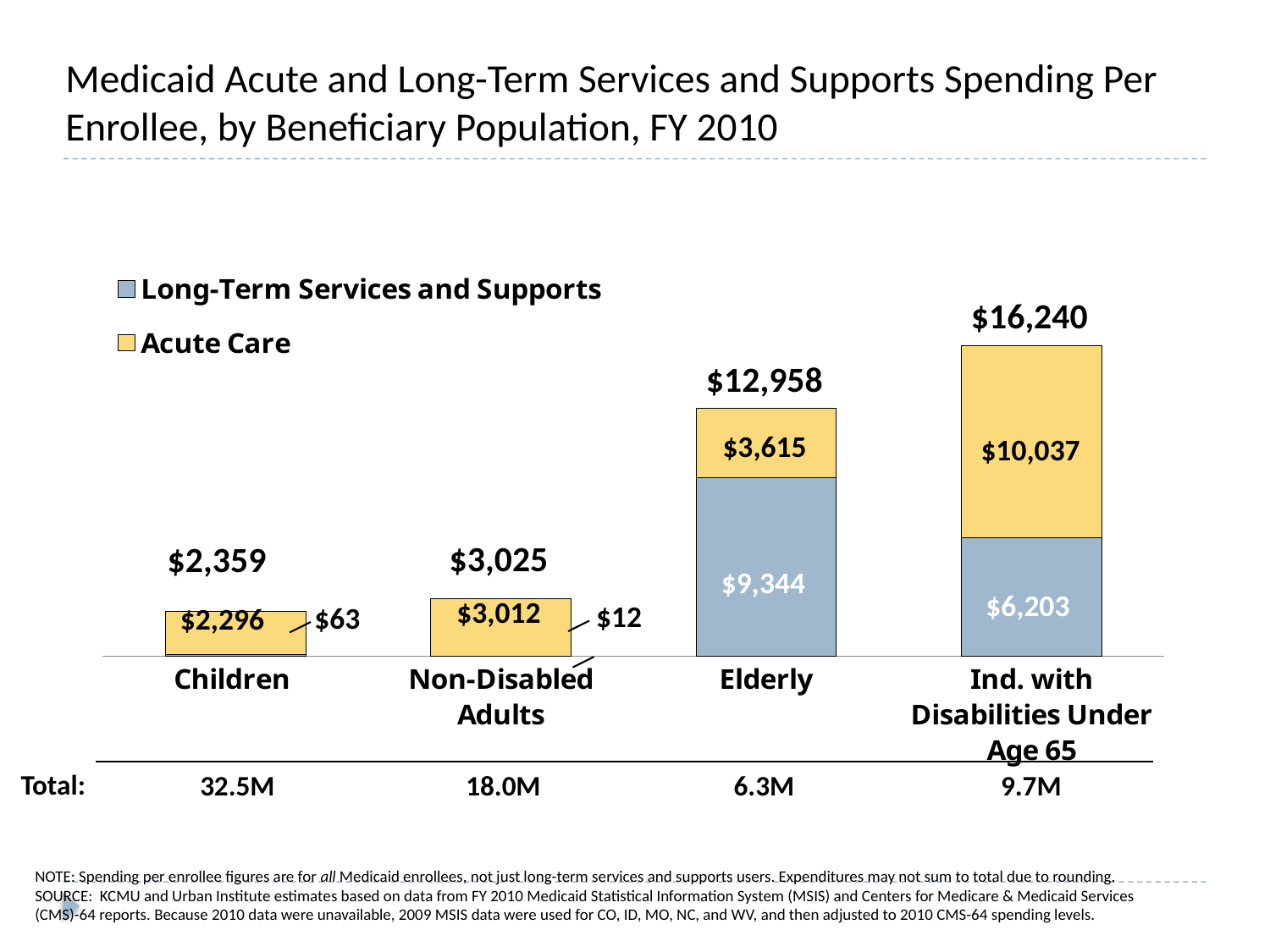
What is the Long-Term Services and Supports spending per enrollee for the Elderly? $9,344 Which beneficiary population has the highest total spending per enrollee? Ind. with Disabilities Under Age 65 How many beneficiary populations are shown on the chart? 4 What is the difference between the Acute Care spending per enrollee for Ind. with Disabilities Under Age 65 and for the Elderly? $6,422 How many series does the legend list? 2 What is the total spending per enrollee shown above the Elderly bar? $12,958 What is the Long-Term Services and Supports spending per enrollee for Non-Disabled Adults? $12 Which is larger for the Elderly: Acute Care spending or Long-Term Services and Supports spending per enrollee? Long-Term Services and Supports What is the Acute Care spending per enrollee for Ind. with Disabilities Under Age 65? $10,037 What is the Acute Care spending per enrollee for Children? $2,296 Which beneficiary population has the lowest total spending per enrollee? Children What type of chart is shown on the slide? Stacked bar chart